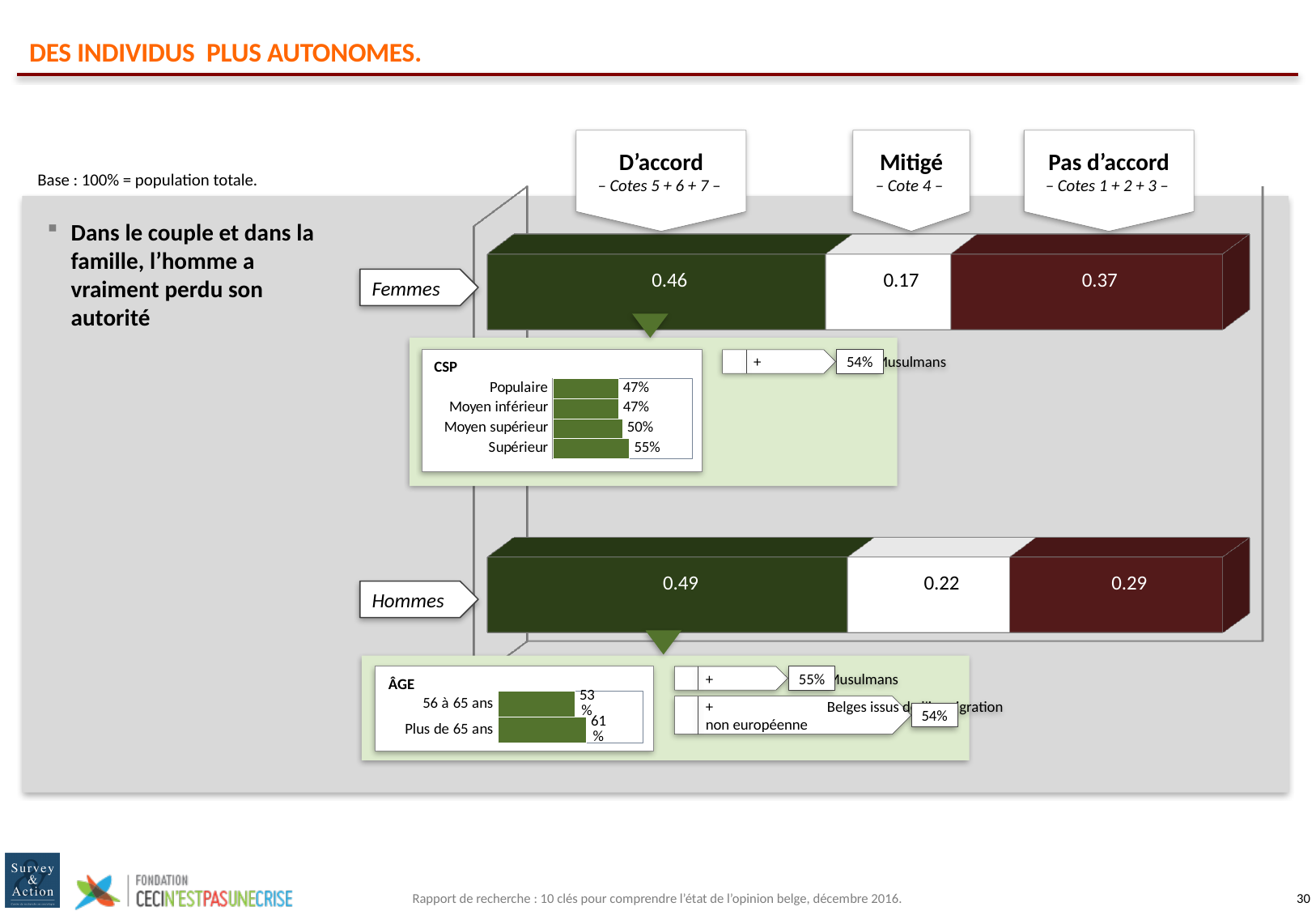
In the main stacked bar chart, what is the 'Pas d'accord' value for Femmes? 0.37 How many groups (bars) are shown in the main stacked bar chart? 2 In the CSP chart, which category has the highest value? Supérieur What kind of chart is the main Femmes/Hommes chart? Stacked bar chart In the main stacked bar chart, what is the 'D'accord' value for Femmes? 0.46 In the main stacked bar chart, what is the 'Mitigé' value for Hommes? 0.22 In the ÂGE chart, what is the value for Plus de 65 ans? 61% In the ÂGE chart, what is the difference between Plus de 65 ans and 56 à 65 ans? 8% In the main stacked bar chart, which group has the higher 'D'accord' value, Femmes or Hommes? Hommes In the CSP chart, what is the value for Supérieur? 55% In the main stacked bar chart, what is the total of the three segments for the Hommes bar? 1.00 In the main stacked bar chart, what is the difference between the 'Pas d'accord' values for Femmes and Hommes? 0.08